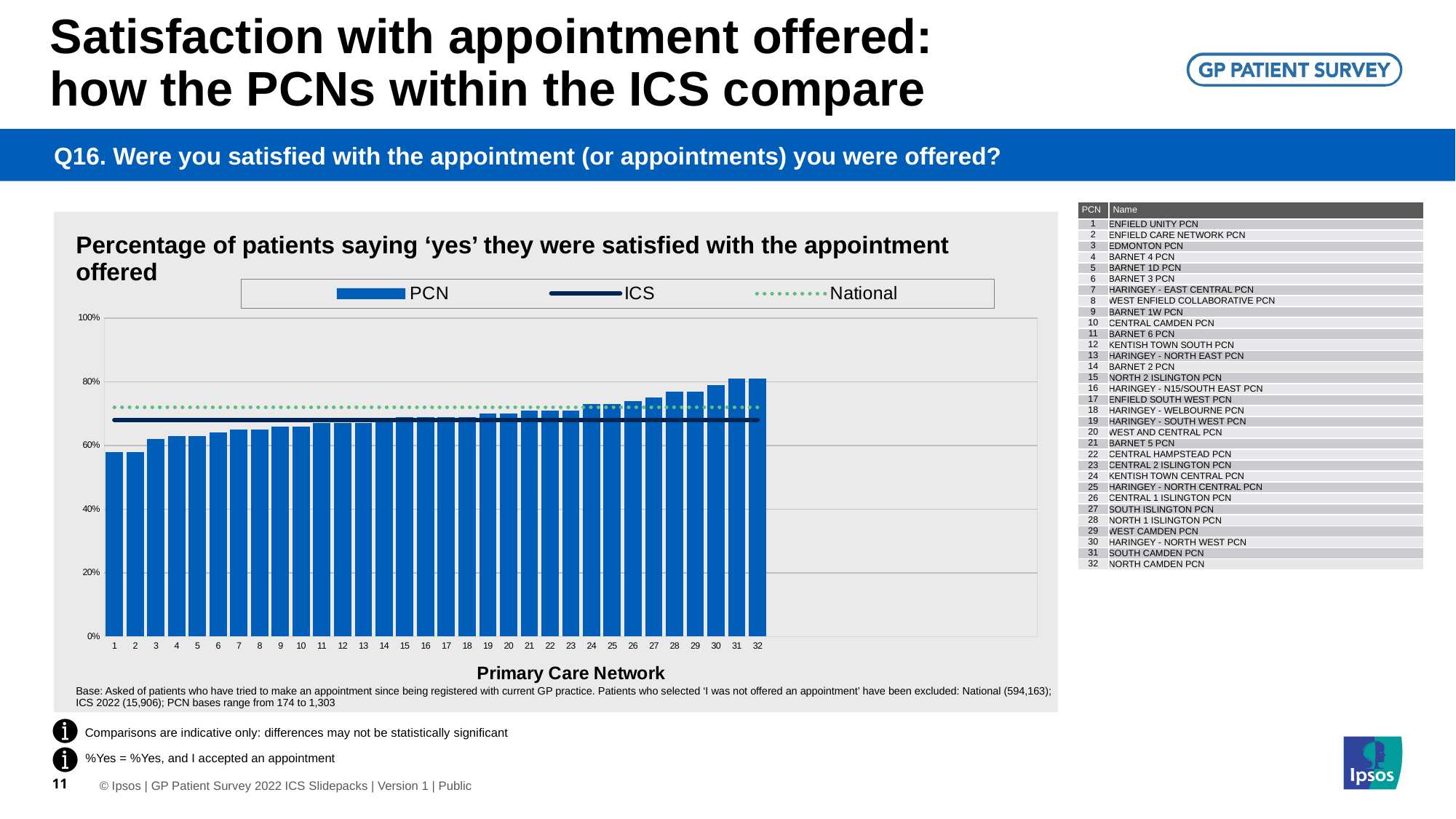
What is the label on the x axis of the chart? Primary Care Network Is the value for PCN 28 greater or less than 80%? less What are the three entries in the chart legend? PCN, ICS, National Is the value for PCN 16 greater or less than 60%? greater Do the bar values rise or fall moving from PCN 1 to PCN 32 along the x axis? rise Which has the larger value, PCN 10 or PCN 25? PCN 25 What kind of chart is shown on the slide? bar chart Is the value for PCN 1 greater or less than 60%? less How many series does the chart legend list? 3 Which has the larger value, PCN 1 or PCN 32? PCN 32 How many Primary Care Networks (bars) are plotted on the chart? 32